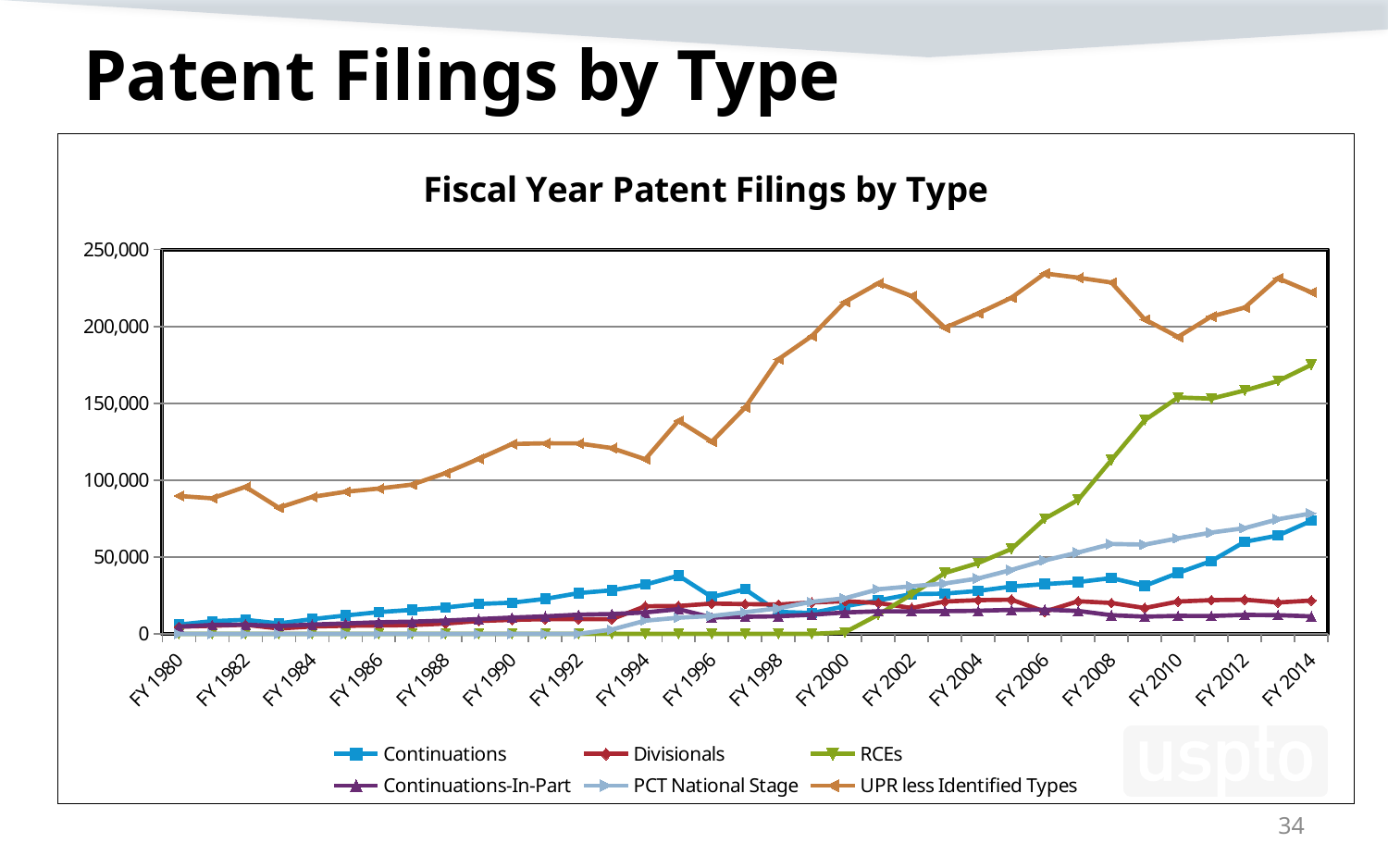
What is the title of the chart? Fiscal Year Patent Filings by Type Do the values for RCEs rise or fall between FY 2006 and FY 2014? rise In FY 2014, which is larger: RCEs or Continuations? RCEs Which series has the highest values across the whole period shown? UPR less Identified Types Is the value for Continuations in FY 2014 greater or less than 100,000? less Is the value for RCEs in FY 2014 greater or less than 150,000? greater What colour is the line for RCEs? green Which series has the lowest value in FY 2014? Continuations-In-Part What kind of chart is shown on the slide? line chart Is the value for UPR less Identified Types in FY 2014 greater or less than 200,000? greater How many series does the legend list? 6